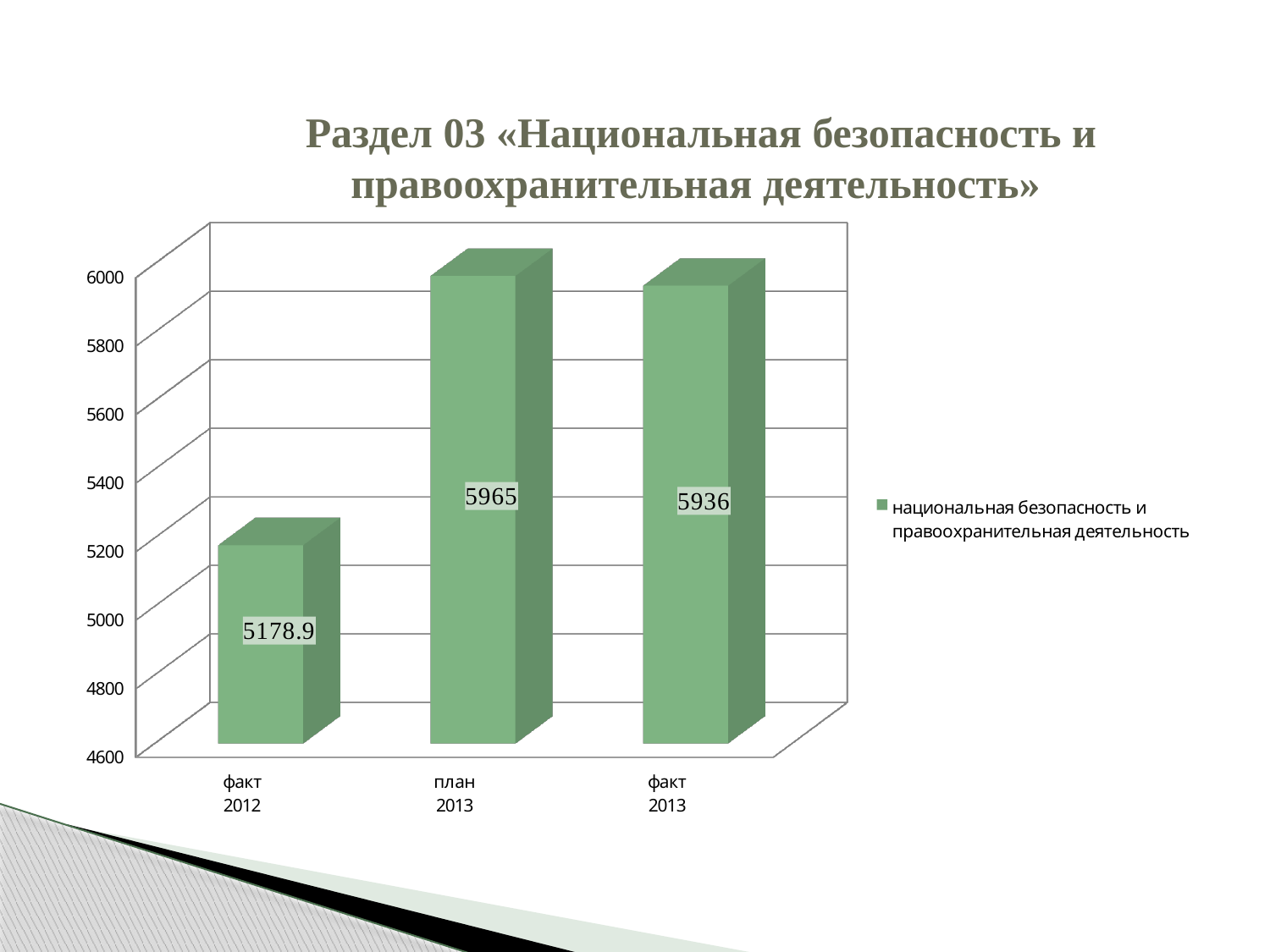
What is the difference between факт 2013 and факт 2012? 757.1 What is the value for факт 2012? 5178.9 Is the value for факт 2012 greater or less than 5200? less What is the value for факт 2013? 5936 How many categories are shown on the x axis? 3 Which category has the lowest value? факт 2012 Which category has the highest value? план 2013 What is the difference between план 2013 and факт 2013? 29 What kind of chart is shown on the slide? bar chart What series name does the legend list? национальная безопасность и правоохранительная деятельность What is the value for план 2013? 5965 Which is larger, факт 2012 or факт 2013? факт 2013